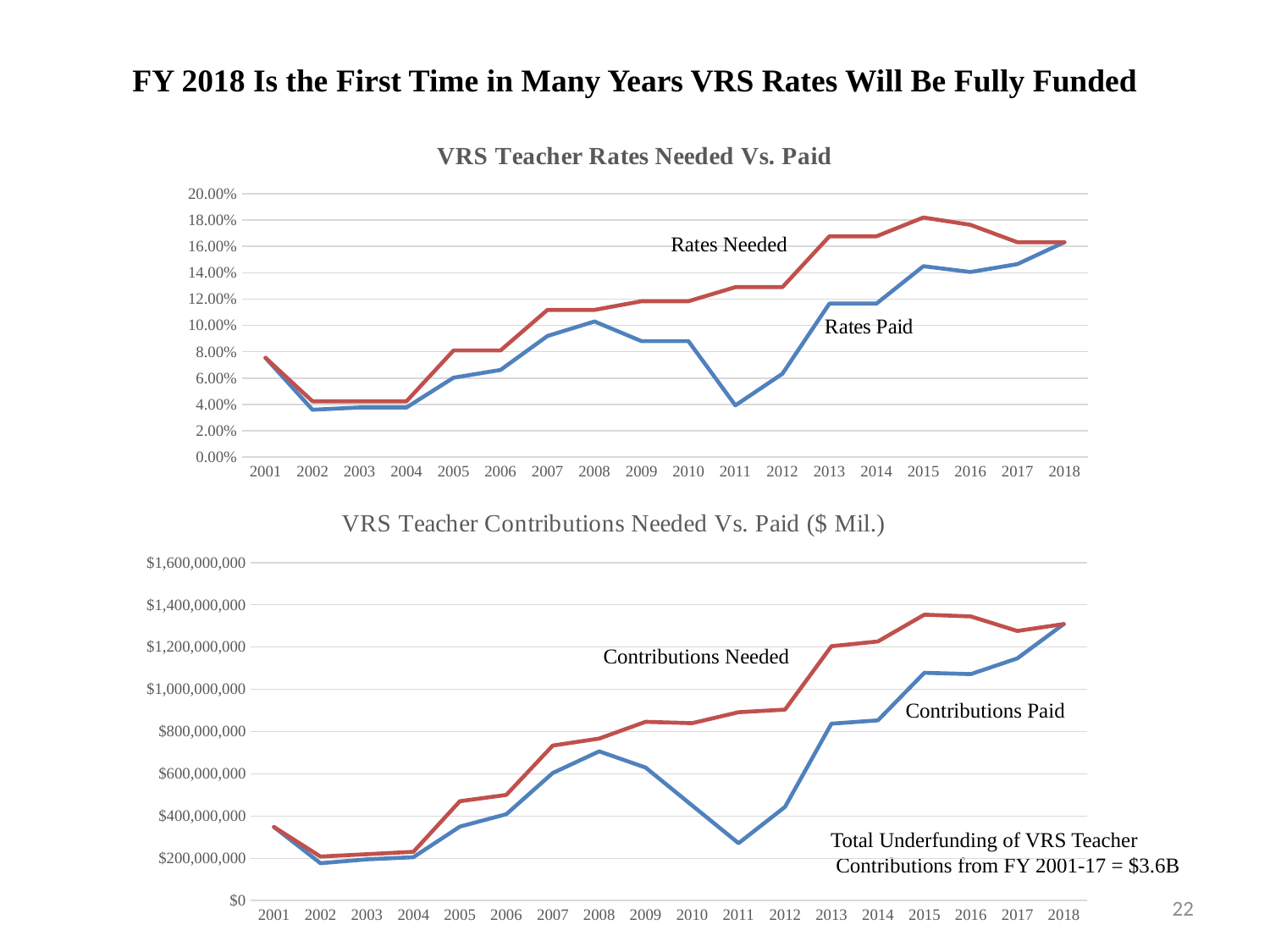
In the top chart, 'VRS Teacher Rates Needed Vs. Paid', in which year is the Rates Paid line at its highest? 2018 In the top chart, 'VRS Teacher Rates Needed Vs. Paid', which series has the larger value in 2012, Rates Needed or Rates Paid? Rates Needed In the bottom chart, 'VRS Teacher Contributions Needed Vs. Paid ($ Mil.)', in which year is the Contributions Needed line at its highest? 2015 In the top chart, 'VRS Teacher Rates Needed Vs. Paid', is the Rates Needed value for 2013 greater or less than 16.00%? greater In the top chart, 'VRS Teacher Rates Needed Vs. Paid', how many years are plotted along the x axis? 18 According to the text on the bottom chart, what is the total underfunding of VRS Teacher Contributions from FY 2001-17? $3.6B In the top chart, 'VRS Teacher Rates Needed Vs. Paid', in which year is the Rates Needed line at its highest? 2015 What kind of chart is the top chart, 'VRS Teacher Rates Needed Vs. Paid'? Line chart In the top chart, 'VRS Teacher Rates Needed Vs. Paid', how many series are plotted? 2 In the bottom chart, 'VRS Teacher Contributions Needed Vs. Paid ($ Mil.)', is the Contributions Paid value for 2011 greater or less than $400,000,000? less In the bottom chart, 'VRS Teacher Contributions Needed Vs. Paid ($ Mil.)', is the Contributions Needed value for 2013 greater or less than $1,000,000,000? greater